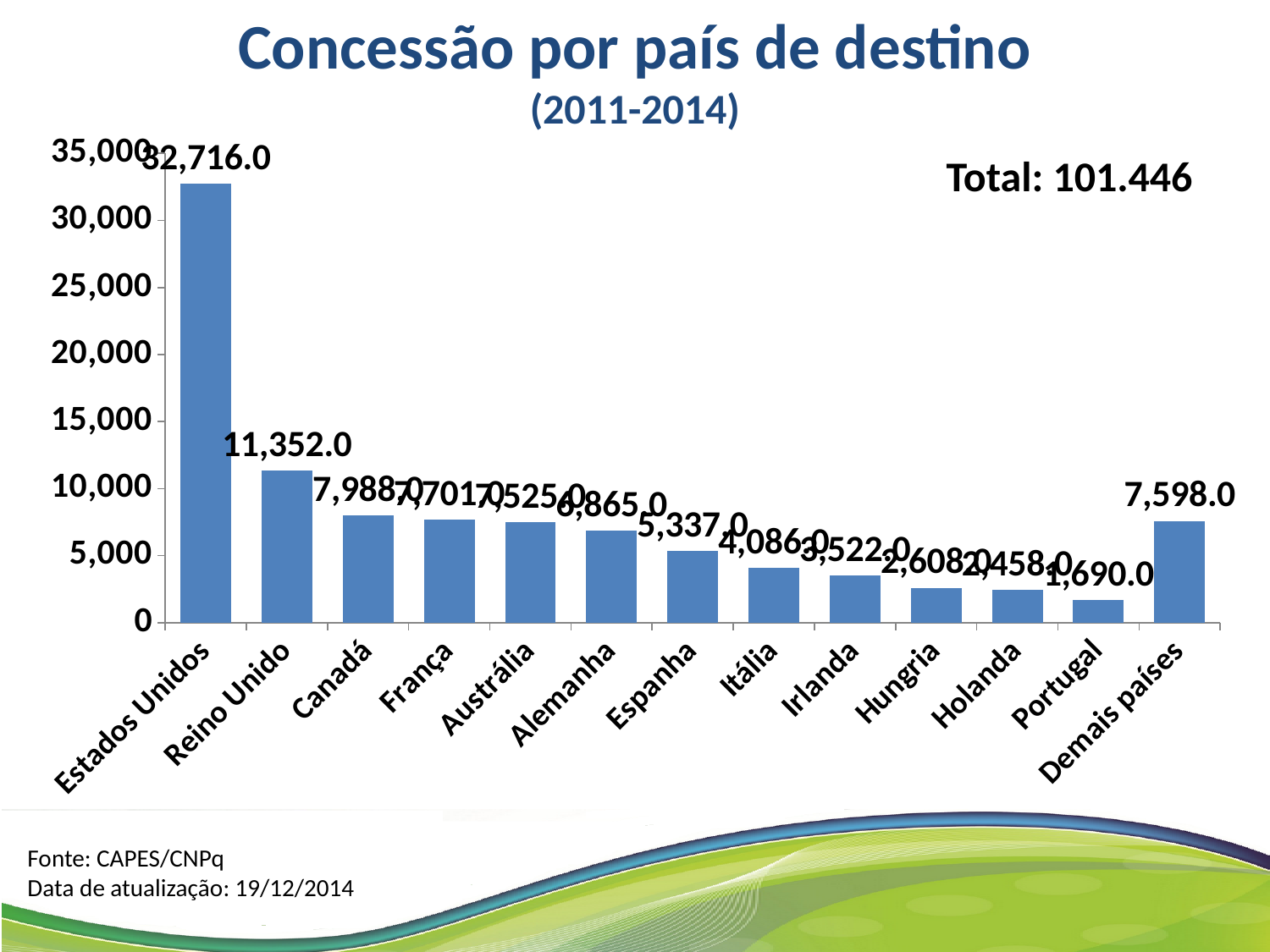
What is the value shown for Reino Unido? 11,352.0 What is the value shown for Demais países? 7,598.0 What is the difference between the values for Estados Unidos and Reino Unido? 21,364.0 What is the value shown for Portugal? 1,690.0 What is the value shown for Estados Unidos? 32,716.0 Which named country has the lowest bar in the chart? Portugal Is the value for Canadá greater or less than 10,000? less Which destination country has the highest number of concessions? Estados Unidos What kind of chart is shown on the slide? bar chart What is the value shown for Alemanha? 6,865.0 How many countries/categories are shown on the x axis of the chart? 13 Which has a larger value, Espanha or Alemanha? Alemanha